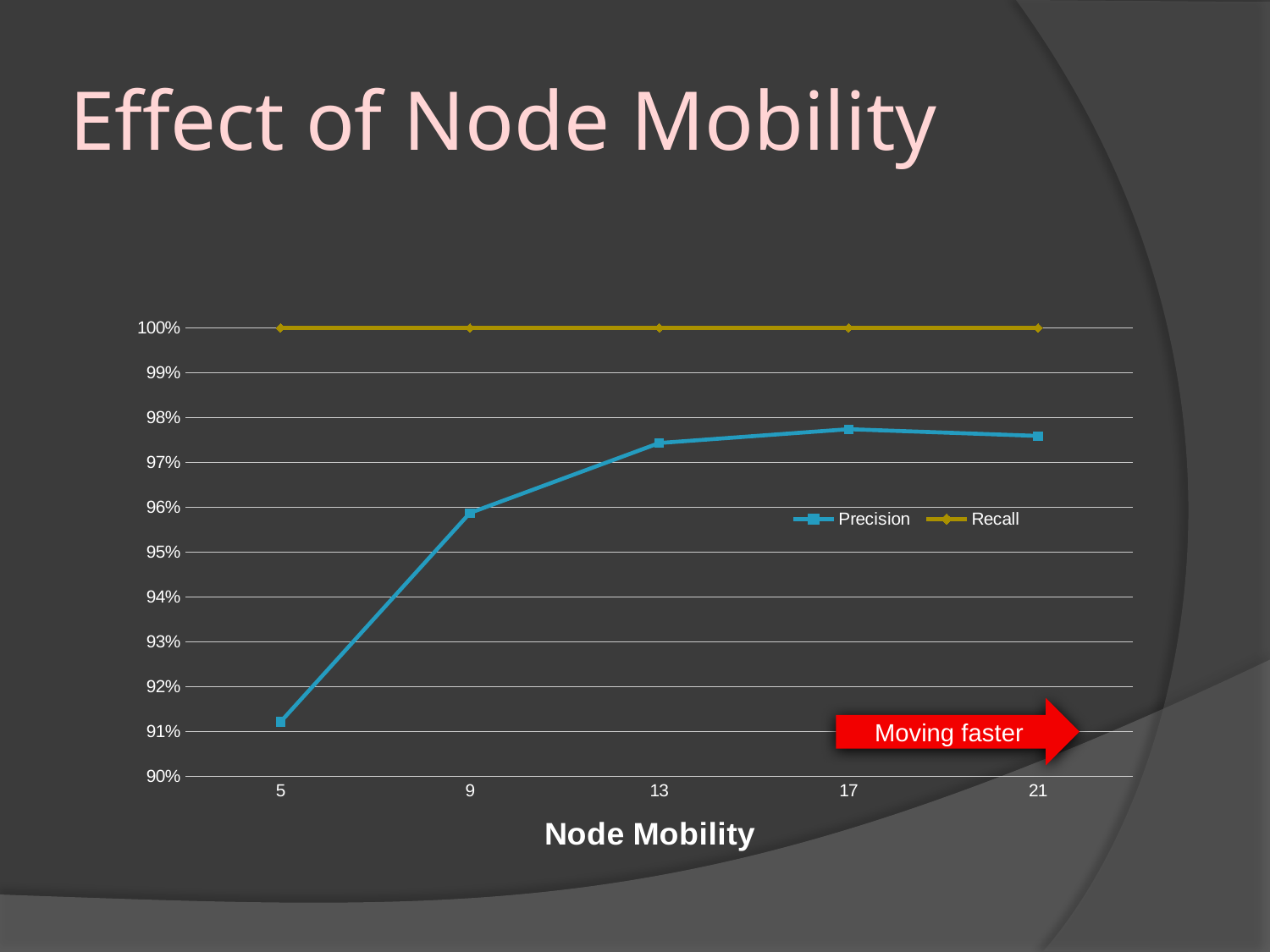
Is the Precision value at node mobility 5 greater or less than 92%? less How many node mobility values are plotted along the x axis? 5 What is the title of the x axis? Node Mobility What kind of chart is shown on the slide? Line chart What is the Recall value at node mobility 13? 100% Does Precision rise or fall as node mobility increases from 5 to 13? Rise Which is larger, Precision at node mobility 5 or Precision at node mobility 9? Precision at node mobility 9 Is the Precision value at node mobility 17 greater or less than 98%? less At which node mobility value is Precision lowest? 5 How many series does the legend list? 2 Which is larger at node mobility 13, Precision or Recall? Recall Is the Precision value at node mobility 9 greater or less than 95%? greater